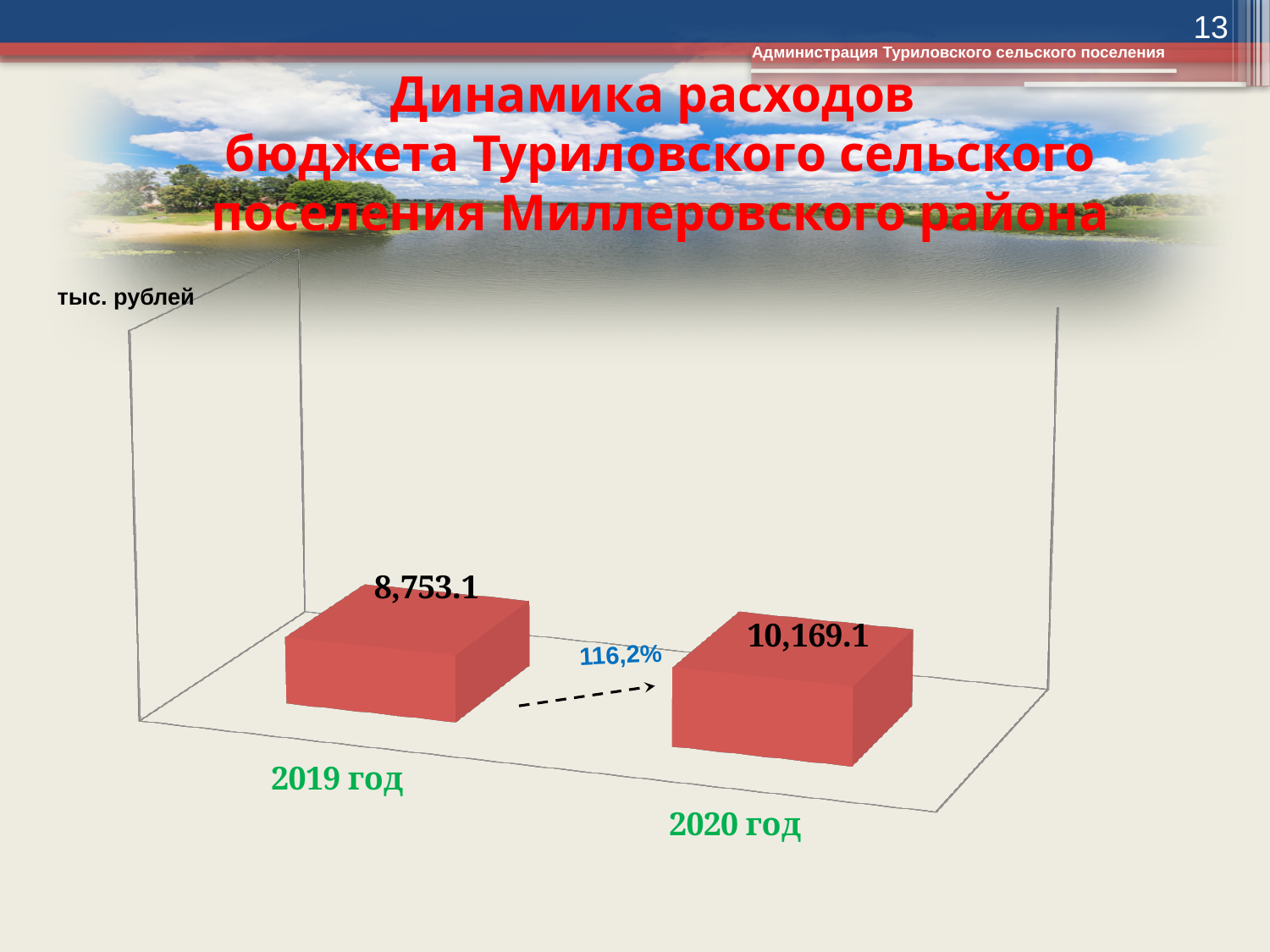
What is the value for 2020 год? 10,169.1 What is the value for 2019 год? 8,753.1 Do the values rise or fall from 2019 год to 2020 год? Rise What percentage is shown on the arrow between the two bars? 116,2% What unit of measurement is indicated on the chart? тыс. рублей Which year has the highest value? 2020 год Which is larger, the value for 2019 год or the value for 2020 год? 2020 год What kind of chart is shown on the slide? Bar chart How many categories are shown in the chart? 2 What is the difference between the values for 2020 год and 2019 год? 1,416.0 Which year has the lowest value? 2019 год